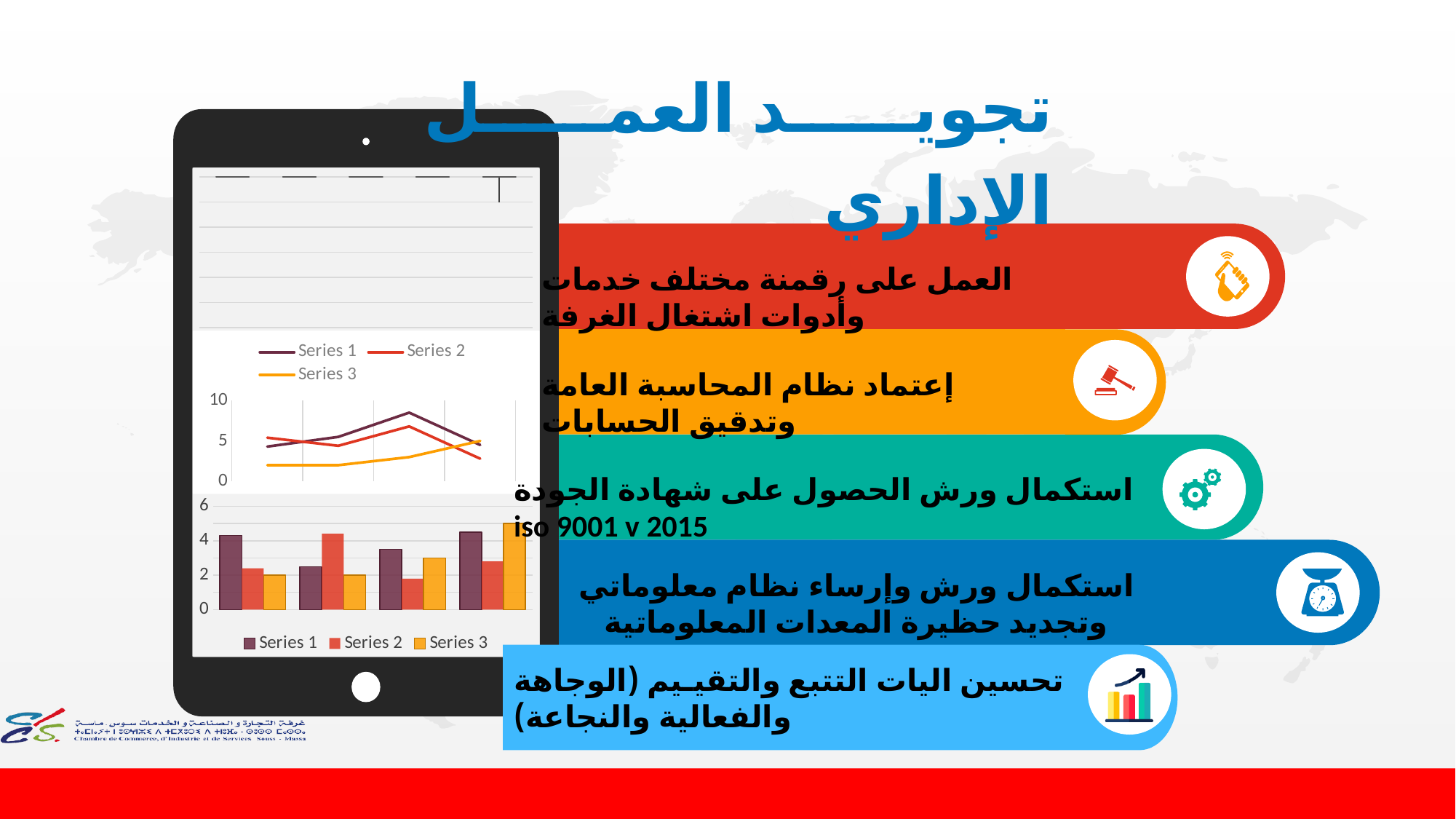
In the upper line chart, is the first value of Series 3 greater or less than 5? less In the upper line chart, is the peak value of Series 1 greater or less than 5? greater In the lower bar chart, how many series does the legend list? 3 What kind of chart is the upper chart on the tablet screen? line chart In the upper line chart, how many series does the legend list? 3 In the lower bar chart, which series has the shortest bar in the third group from the left? Series 2 In the upper line chart, does the Series 3 line rise or fall overall from left to right? rise In the lower bar chart, is the Series 3 bar in the rightmost group greater or less than 4? greater In the lower bar chart, how many groups of bars are plotted along the x axis? 4 In the lower bar chart, which series has the tallest bar in the rightmost group? Series 3 What kind of chart is the lower chart on the tablet screen? bar chart In the upper line chart, what are the names of the series listed in the legend? Series 1, Series 2, Series 3